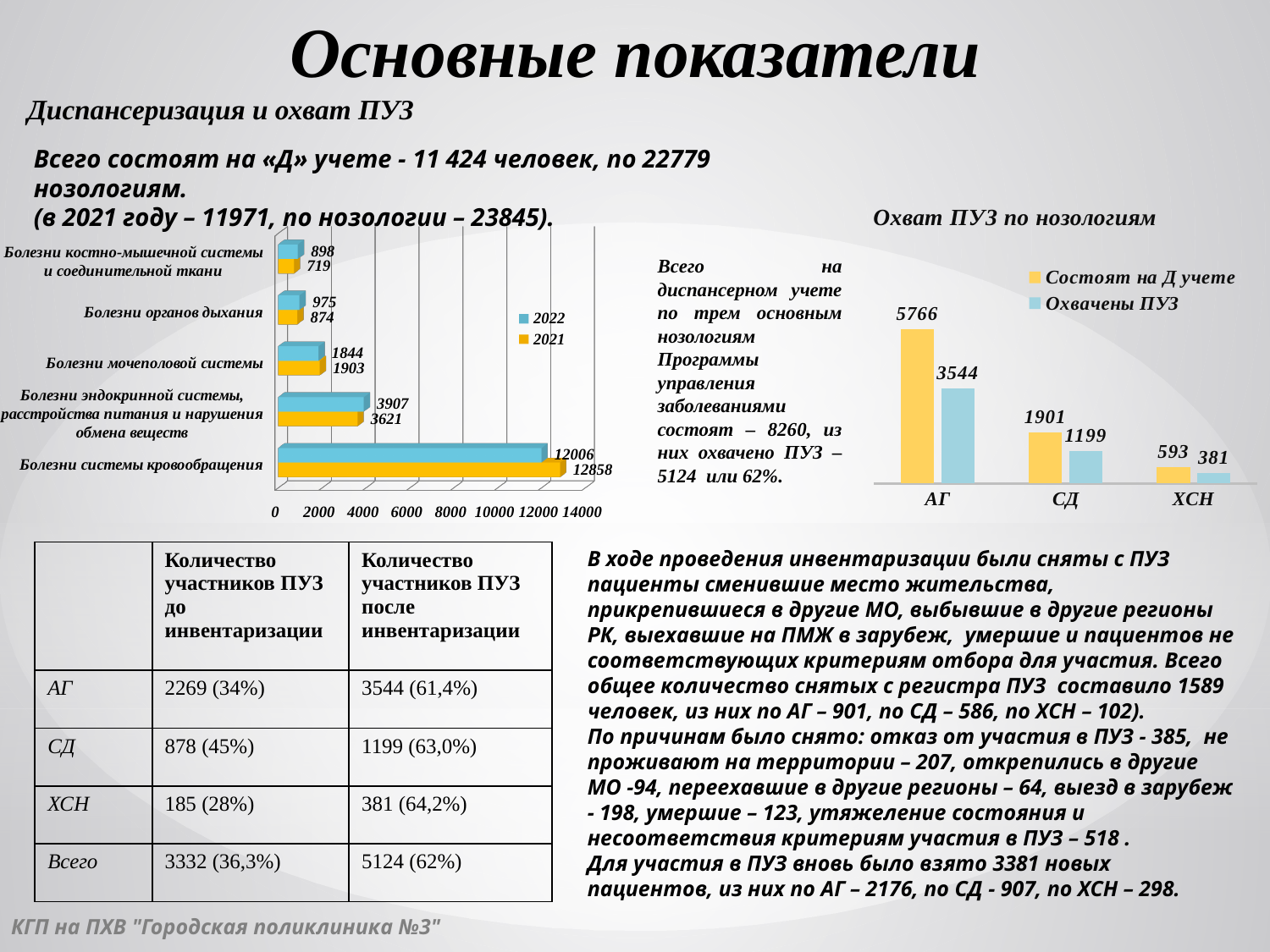
In the chart titled 'Охват ПУЗ по нозологиям', how many series does the legend list? 2 What type of chart is the chart on the left of the slide? bar chart In the chart titled 'Охват ПУЗ по нозологиям', what is the difference between 'Состоят на Д учете' and 'Охвачены ПУЗ' for АГ? 2222 In the horizontal bar chart on the left, what is the 2021 value for 'Болезни системы кровообращения'? 12858 In the horizontal bar chart on the left, what is the 2022 value for 'Болезни органов дыхания'? 975 In the chart titled 'Охват ПУЗ по нозологиям', how many categories are shown on the x axis? 3 In the horizontal bar chart on the left, what is the difference between the 2022 and 2021 values for 'Болезни эндокринной системы, расстройства питания и нарушения обмена веществ'? 286 In the horizontal bar chart on the left, which is larger for 'Болезни мочеполовой системы': the 2022 value or the 2021 value? 2021 In the chart titled 'Охват ПУЗ по нозологиям', which category has the lowest 'Охвачены ПУЗ' value? ХСН In the horizontal bar chart on the left, which category has the highest 2022 value? Болезни системы кровообращения In the chart titled 'Охват ПУЗ по нозологиям', what is the value of 'Состоят на Д учете' for АГ? 5766 In the chart titled 'Охват ПУЗ по нозологиям', what is the value of 'Охвачены ПУЗ' for СД? 1199